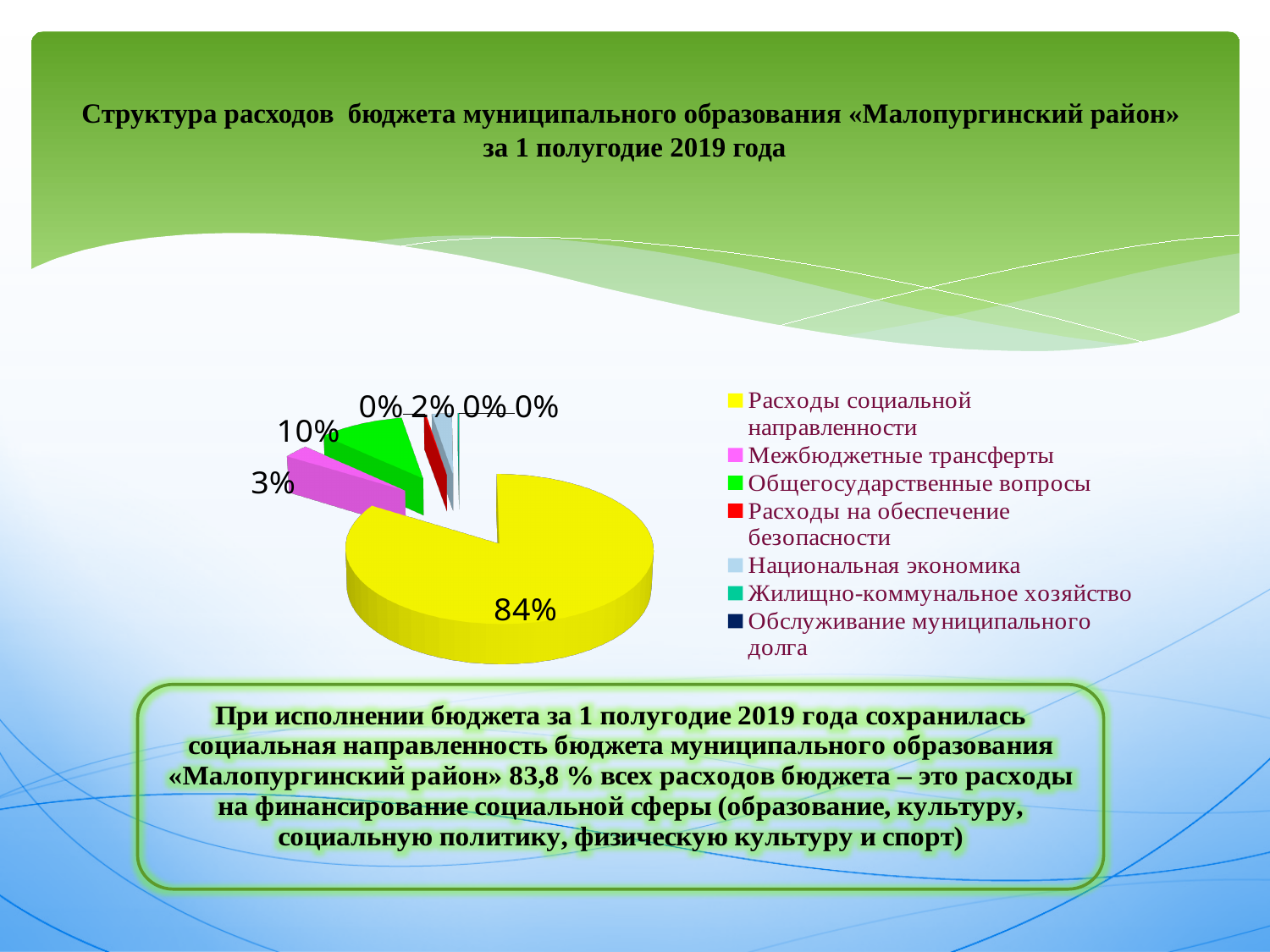
What share of the pie is labelled for Расходы социальной направленности? 84% What colour is the slice for Расходы социальной направленности? yellow What type of chart is shown on the slide? pie chart What is the difference in percentage points between the slice for Общегосударственные вопросы and the slice for Межбюджетные трансферты? 7 Which is larger: the slice for Общегосударственные вопросы or the slice for Межбюджетные трансферты? Общегосударственные вопросы Which category has the largest slice of the pie? Расходы социальной направленности What share of the pie is labelled for Межбюджетные трансферты? 3% How many categories does the legend list? 7 What share of the pie is labelled for Общегосударственные вопросы? 10% What is the difference in percentage points between the slice for Расходы социальной направленности and the slice for Общегосударственные вопросы? 74 Which category is shown in green in the legend? Общегосударственные вопросы Is the slice for Расходы социальной направленности greater or less than 50% of the pie? greater